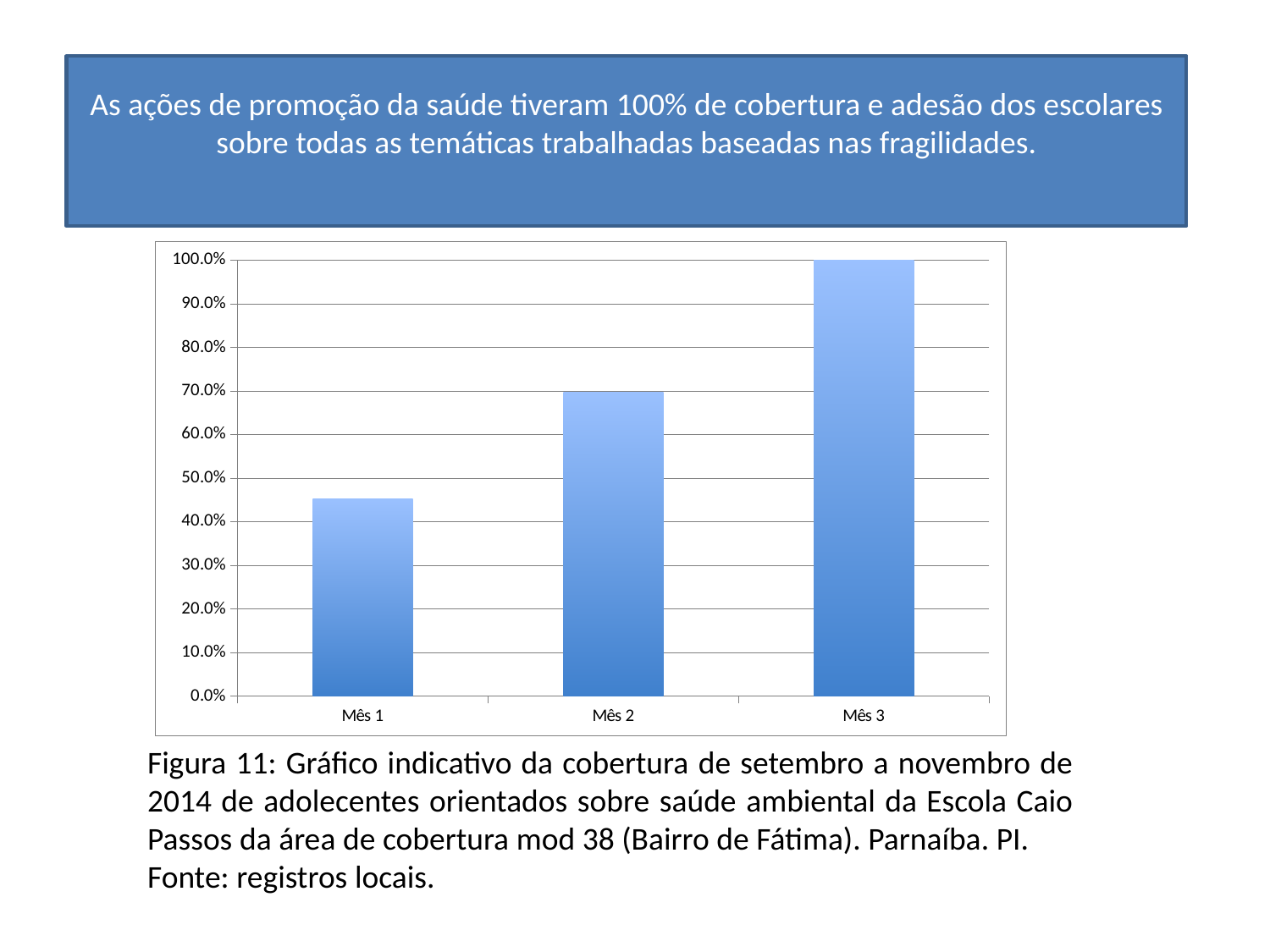
Do the values rise or fall from Mês 1 to Mês 3? rise What kind of chart is shown on the slide? bar chart Which month has the lowest value in the chart? Mês 1 How many categories (months) are plotted on the x axis of the chart? 3 Is the value for Mês 1 greater or less than 40.0%? greater What is the value for Mês 3? 100.0% Which is larger, the value for Mês 2 or the value for Mês 1? Mês 2 Is the value for Mês 1 greater or less than 50.0%? less What figure number does the caption below the chart give? Figura 11 Which month has the highest value in the chart? Mês 3